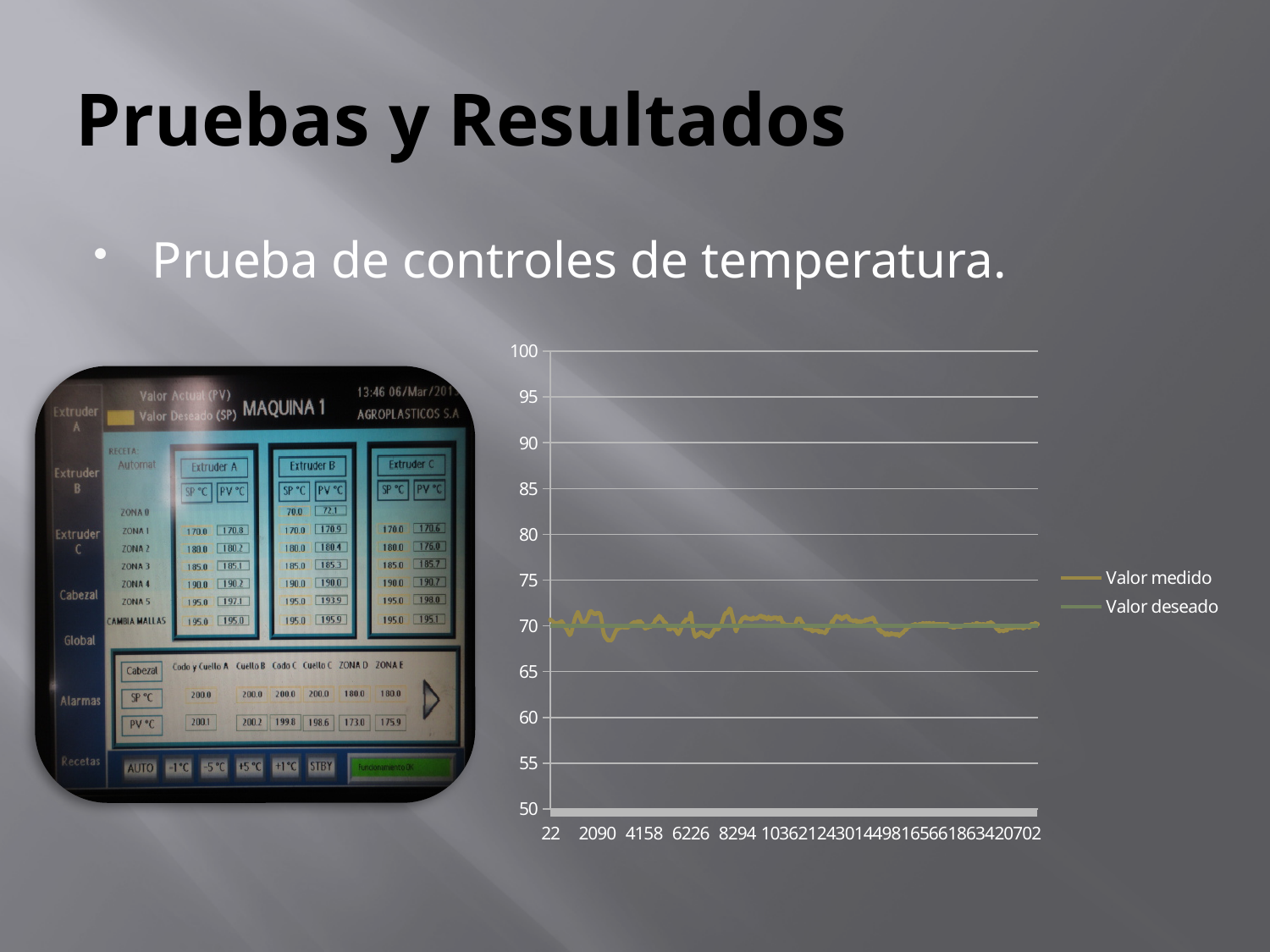
What is the highest value shown on the y axis of the chart? 100 Does the Valor deseado line rise, fall, or stay flat along the x axis? stays flat What kind of chart is shown on the right side of the slide? line chart Is the value of Valor medido greater or less than 80 across the chart? less How many labels are shown on the x axis of the chart? 11 What is the last label on the x axis of the chart? 20702 At what value does the Valor deseado line sit throughout the chart? 70 Is the value of Valor medido greater or less than 60 across the chart? greater What are the two series named in the chart legend? Valor medido and Valor deseado What is the first label on the x axis of the chart? 22 How many series does the chart legend list? 2 Which series in the chart is drawn in green? Valor deseado